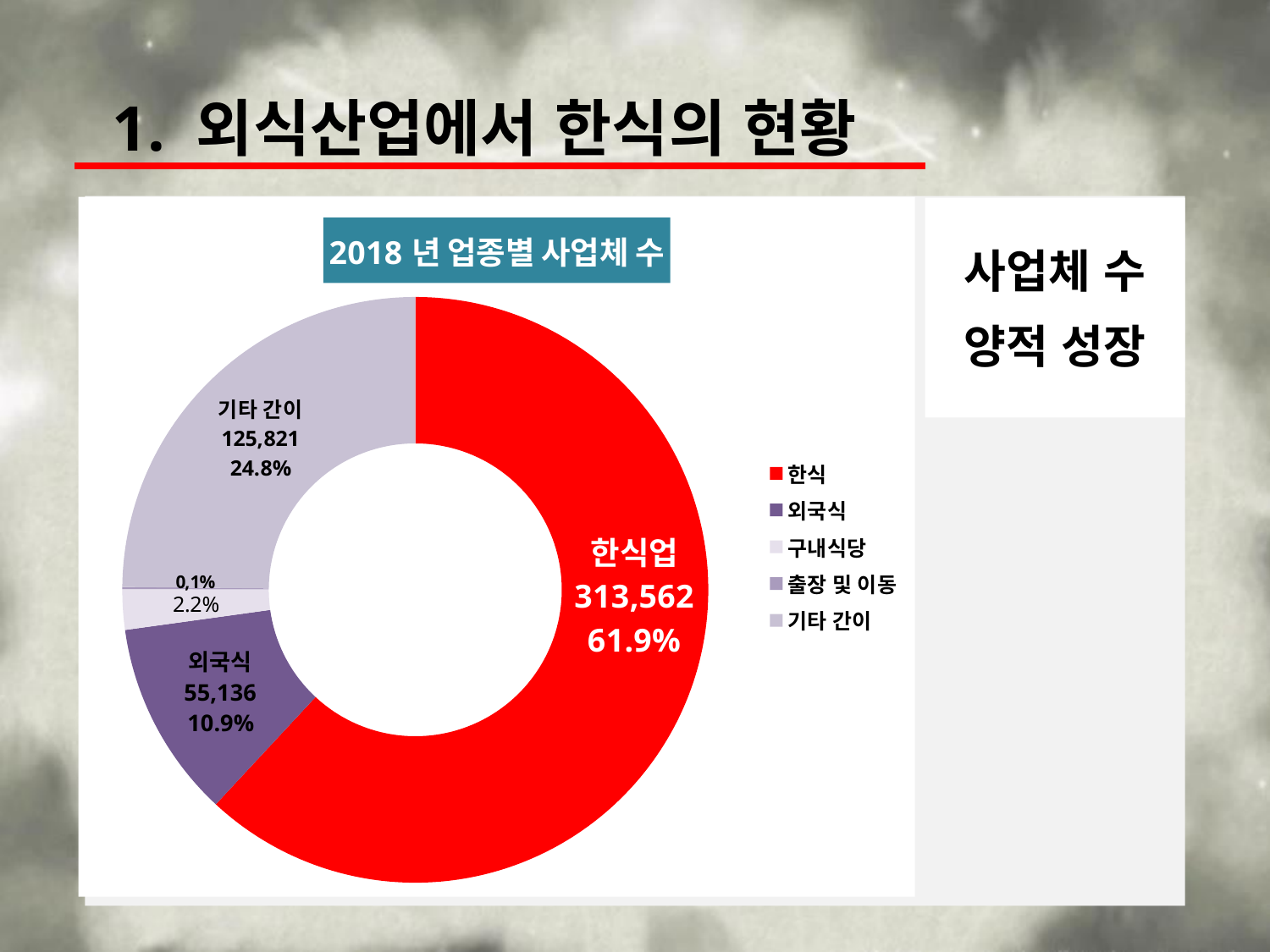
What share of the chart does 외국식 account for? 10.9% Which category has the largest slice? 한식 What share of the chart does 한식업 account for? 61.9% How many businesses are shown for 한식업? 313,562 What is the title of the chart? 2018 년 업종별 사업체 수 What kind of chart is shown on the slide? doughnut chart How many businesses are shown for 기타 간이? 125,821 How many businesses are shown for 외국식? 55,136 What share of the chart does 기타 간이 account for? 24.8% Which has more businesses, 기타 간이 or 외국식? 기타 간이 What is the difference in the number of businesses between 한식업 and 외국식? 258,426 How many categories does the legend list? 5